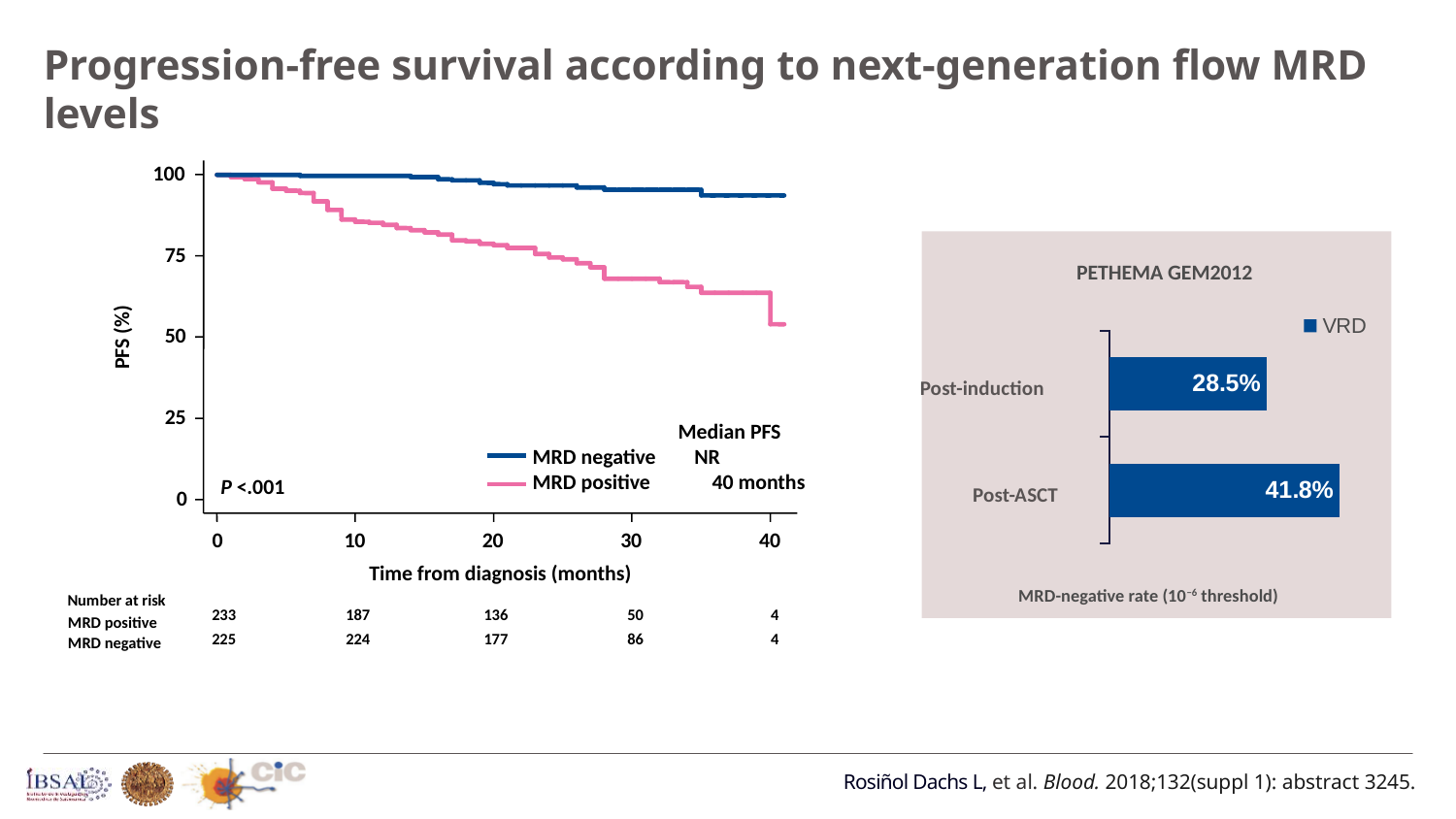
In the progression-free survival chart on the left, what is the median PFS for the MRD negative group? NR In the progression-free survival chart on the left, how many MRD positive patients were at risk at 20 months? 136 In the progression-free survival chart on the left, is the PFS for the MRD positive group at 30 months greater or less than 75%? less In the PETHEMA GEM2012 bar chart, what is the MRD-negative rate post-induction? 28.5% In the PETHEMA GEM2012 bar chart, what is the difference between the post-ASCT and post-induction MRD-negative rates? 13.3% In the PETHEMA GEM2012 bar chart, which category has the higher MRD-negative rate? Post-ASCT What kind of chart is the PETHEMA GEM2012 chart on the right? Bar chart In the PETHEMA GEM2012 bar chart, what is the MRD-negative rate post-ASCT? 41.8% In the PETHEMA GEM2012 bar chart, what series does the legend list? VRD In the progression-free survival chart on the left, does the MRD positive curve rise or fall over time from diagnosis? Fall In the progression-free survival chart on the left, how many groups are shown in the legend? 2 In the progression-free survival chart on the left, what is the median PFS for the MRD positive group? 40 months